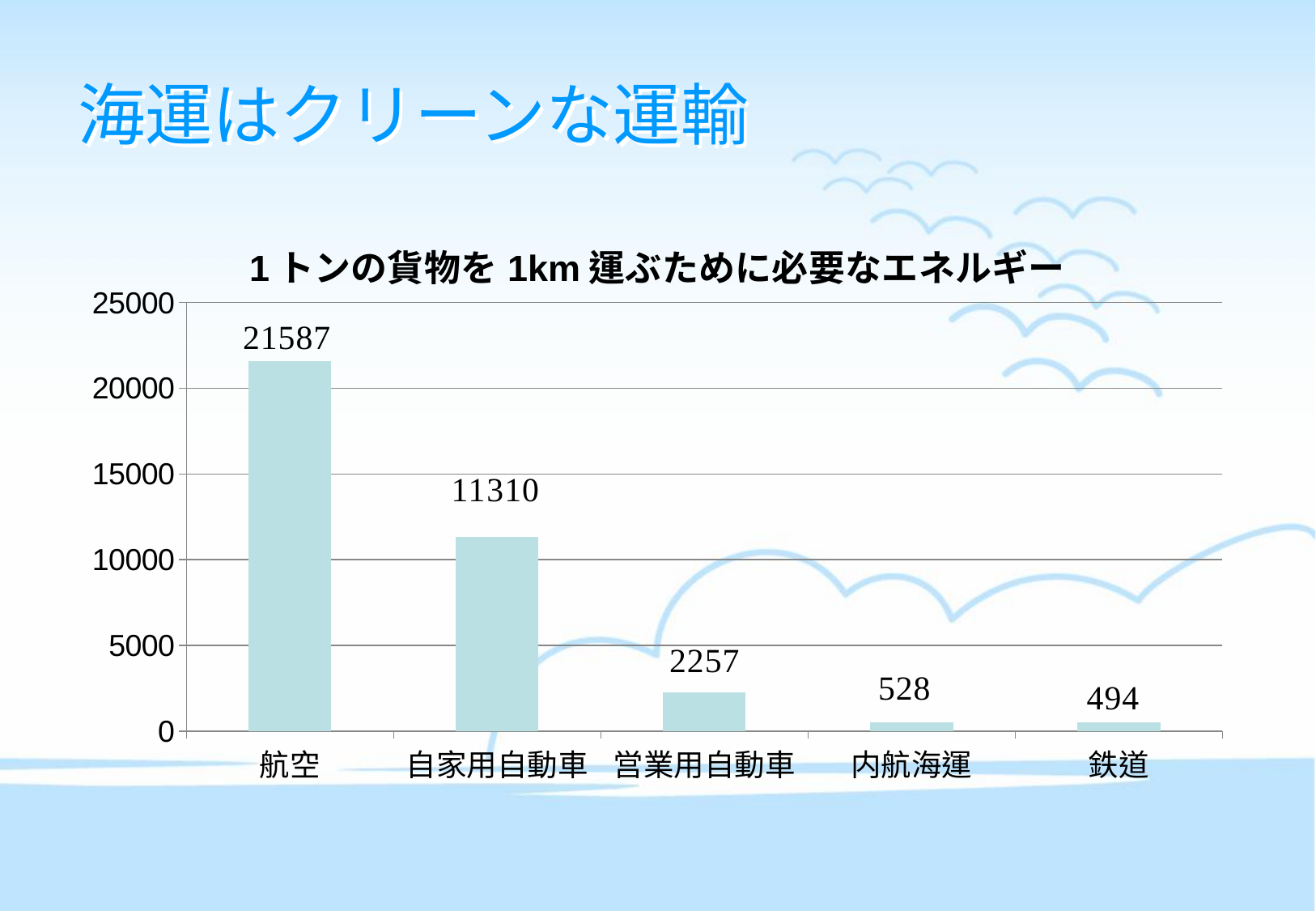
How many categories are shown on the x axis? 5 Which category has the highest value? 航空 What is the value for 鉄道? 494 What is the difference between the values for 内航海運 and 鉄道? 34 What is the value for 航空? 21587 What is the value for 営業用自動車? 2257 What is the value for 自家用自動車? 11310 What kind of chart is shown on the slide? bar chart What is the value for 内航海運? 528 What is the difference between the values for 航空 and 自家用自動車? 10277 Which category has the lowest value? 鉄道 Which is larger, the value for 営業用自動車 or the value for 内航海運? 営業用自動車